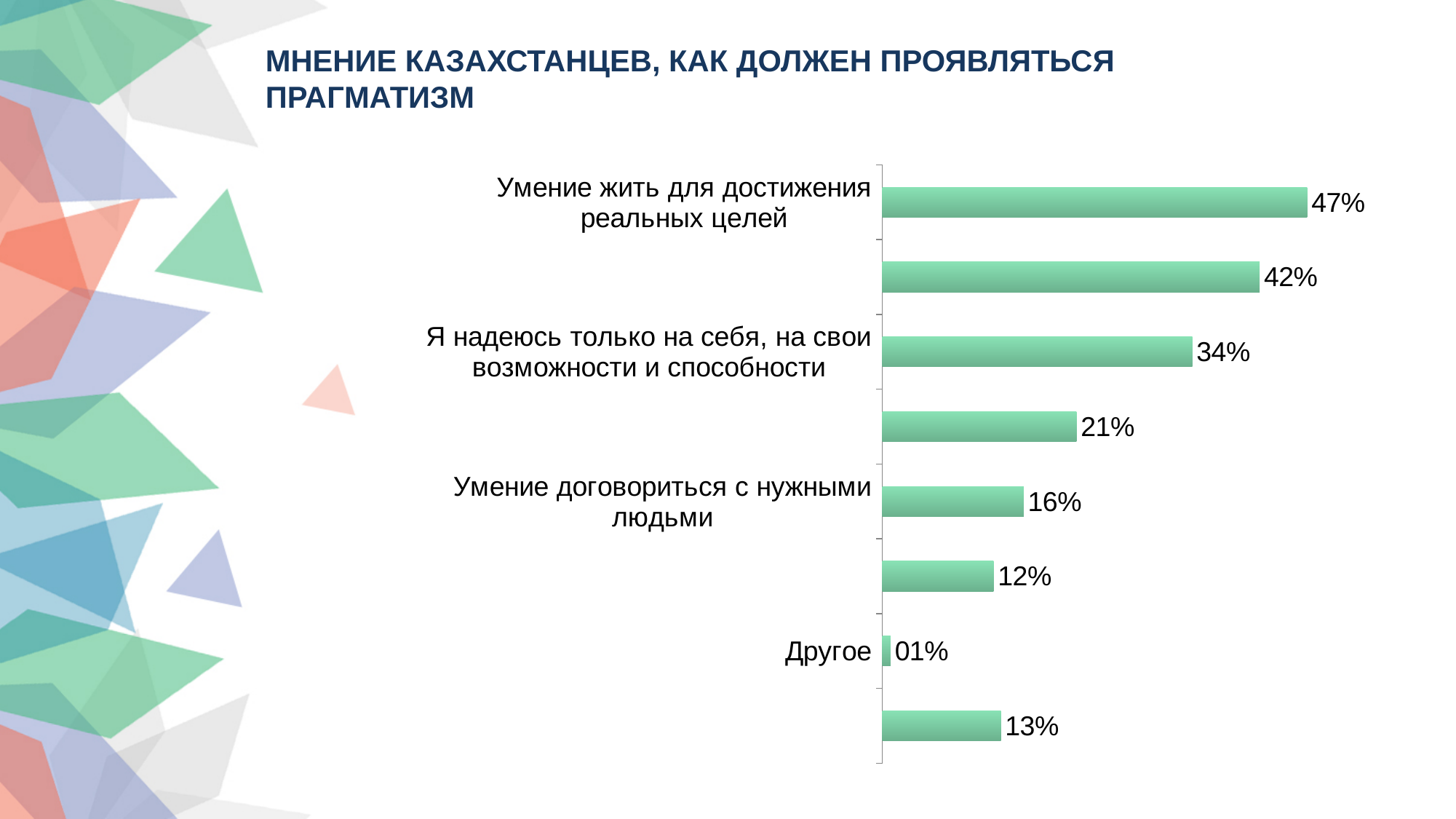
What is the difference between the values for "Умение жить для достижения реальных целей" and "Я надеюсь только на себя, на свои возможности и способности"? 13% What is the value for "Я надеюсь только на себя, на свои возможности и способности"? 34% What is the value for "Умение договориться с нужными людьми"? 16% What is the difference between the values for "Я надеюсь только на себя, на свои возможности и способности" and "Умение договориться с нужными людьми"? 18% Which is larger: the value for "Умение договориться с нужными людьми" or the value for "Другое"? Умение договориться с нужными людьми How many bars are plotted in the chart? 8 What is the title of the slide? МНЕНИЕ КАЗАХСТАНЦЕВ, КАК ДОЛЖЕН ПРОЯВЛЯТЬСЯ ПРАГМАТИЗМ What type of chart is shown on the slide? bar chart Which category has the lowest value? Другое What is the value for "Умение жить для достижения реальных целей"? 47% Which category has the highest value? Умение жить для достижения реальных целей What is the value for "Другое"? 01%